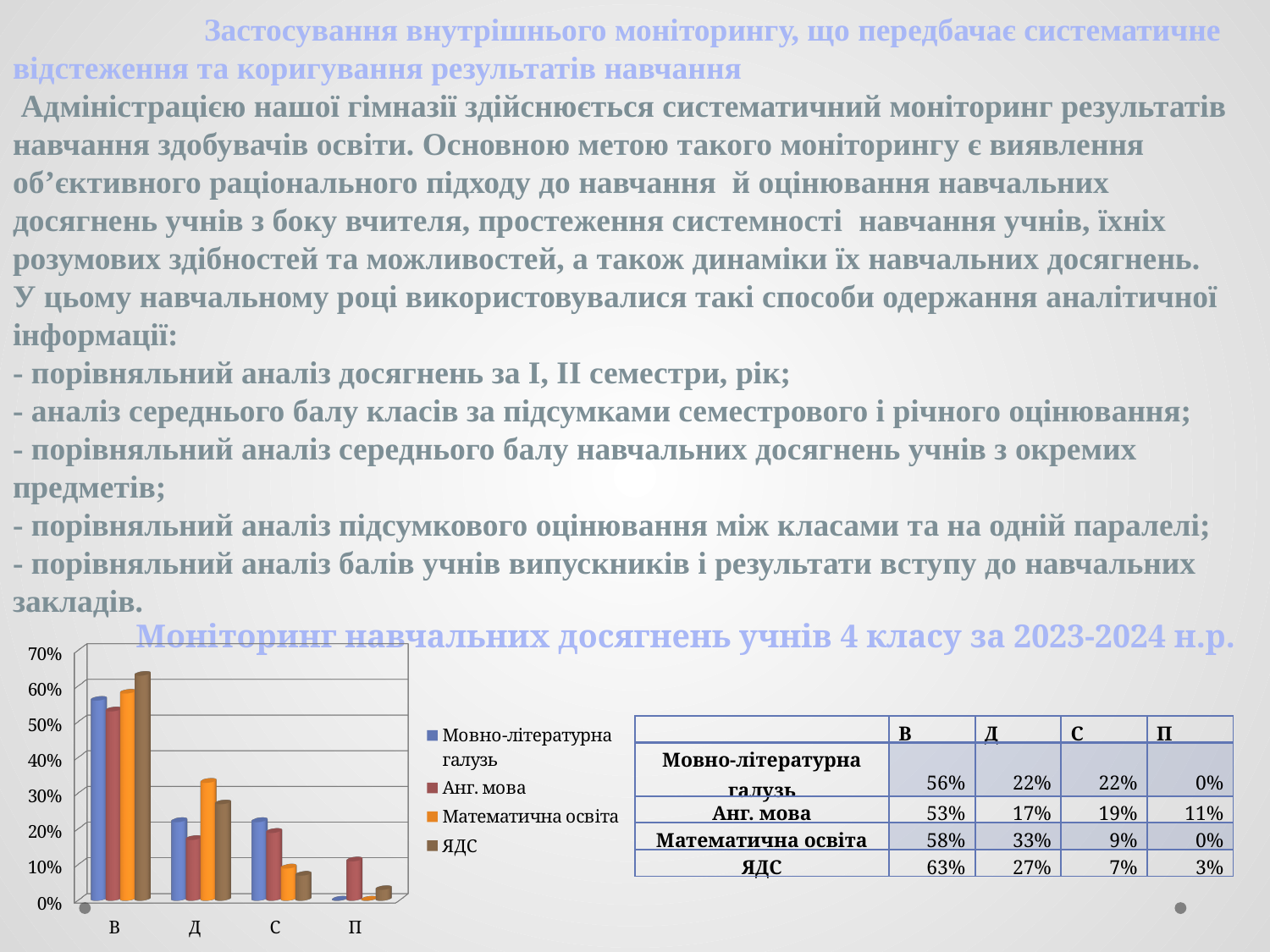
Is the value for Мовно-літературна галузь in category С greater or less than 30%? less What is the difference between the ЯДС values for В and Д? 36% Which series has the lowest value in category Д? Анг. мова How many series does the chart legend list? 4 Do the values for Математична освіта rise or fall from В to П along the x axis? fall What is the value for Анг. мова in category П? 11% How many categories are shown on the x axis of the chart? 4 What is the title of the chart? Моніторинг навчальних досягнень учнів 4 класу за 2023-2024 н.р. What is the value for Математична освіта in category В? 58% In category Д, which is larger: Математична освіта or Анг. мова? Математична освіта What kind of chart is shown on the slide? bar chart Which series has the highest value in category В? ЯДС